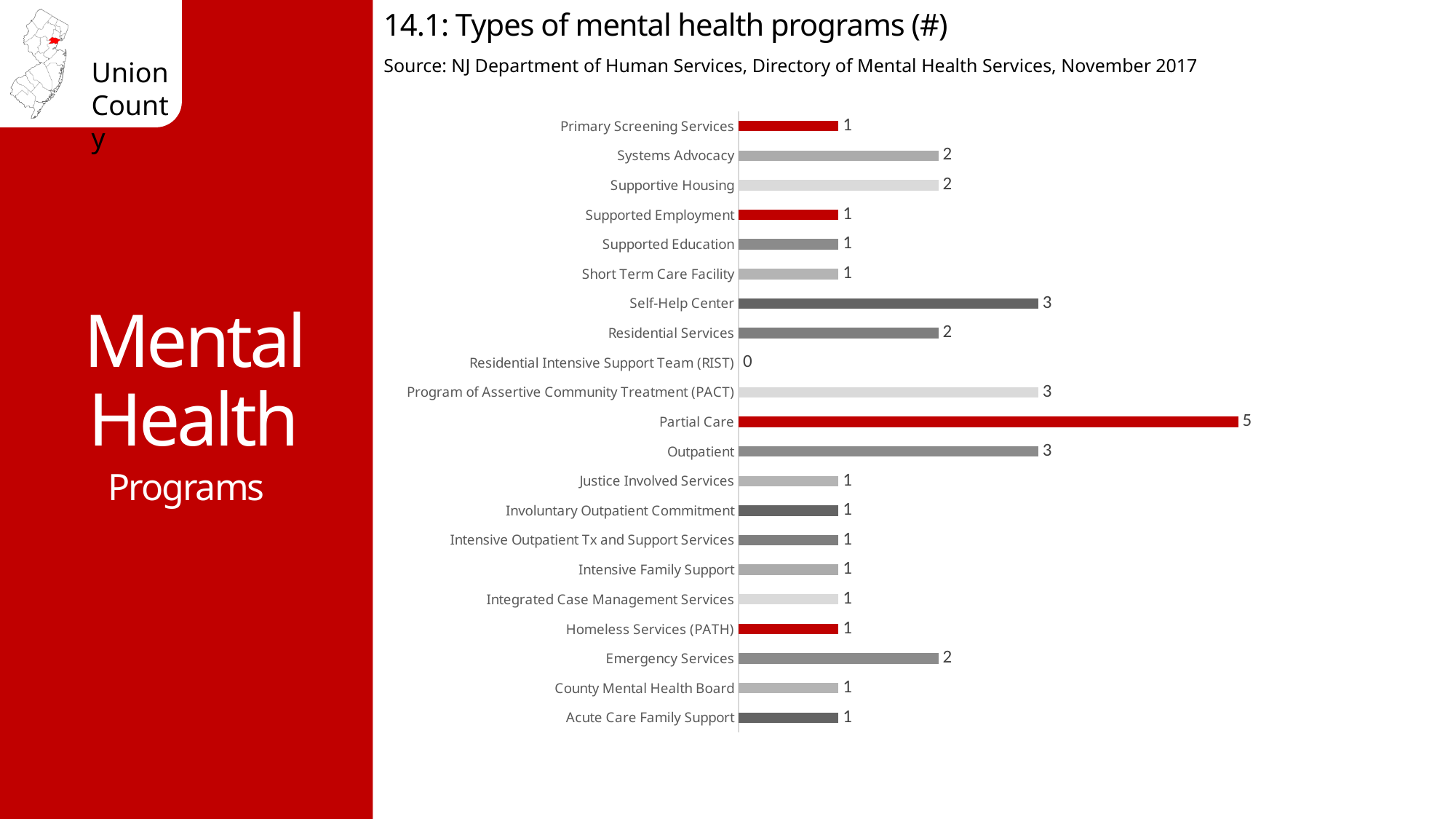
Which category has the lowest value? Residential Intensive Support Team (RIST) What is the value for Self-Help Center? 3 What is the title of the chart? 14.1: Types of mental health programs (#) What is the source cited for the chart? NJ Department of Human Services, Directory of Mental Health Services, November 2017 How many categories are shown in the chart? 21 Which is larger, the value for Systems Advocacy or the value for Supported Employment? Systems Advocacy Which category has the highest value? Partial Care What is the value for Partial Care? 5 What is the value for Residential Intensive Support Team (RIST)? 0 What is the difference between the values for Partial Care and Outpatient? 2 What kind of chart is shown on the slide? Bar chart What is the value for Emergency Services? 2